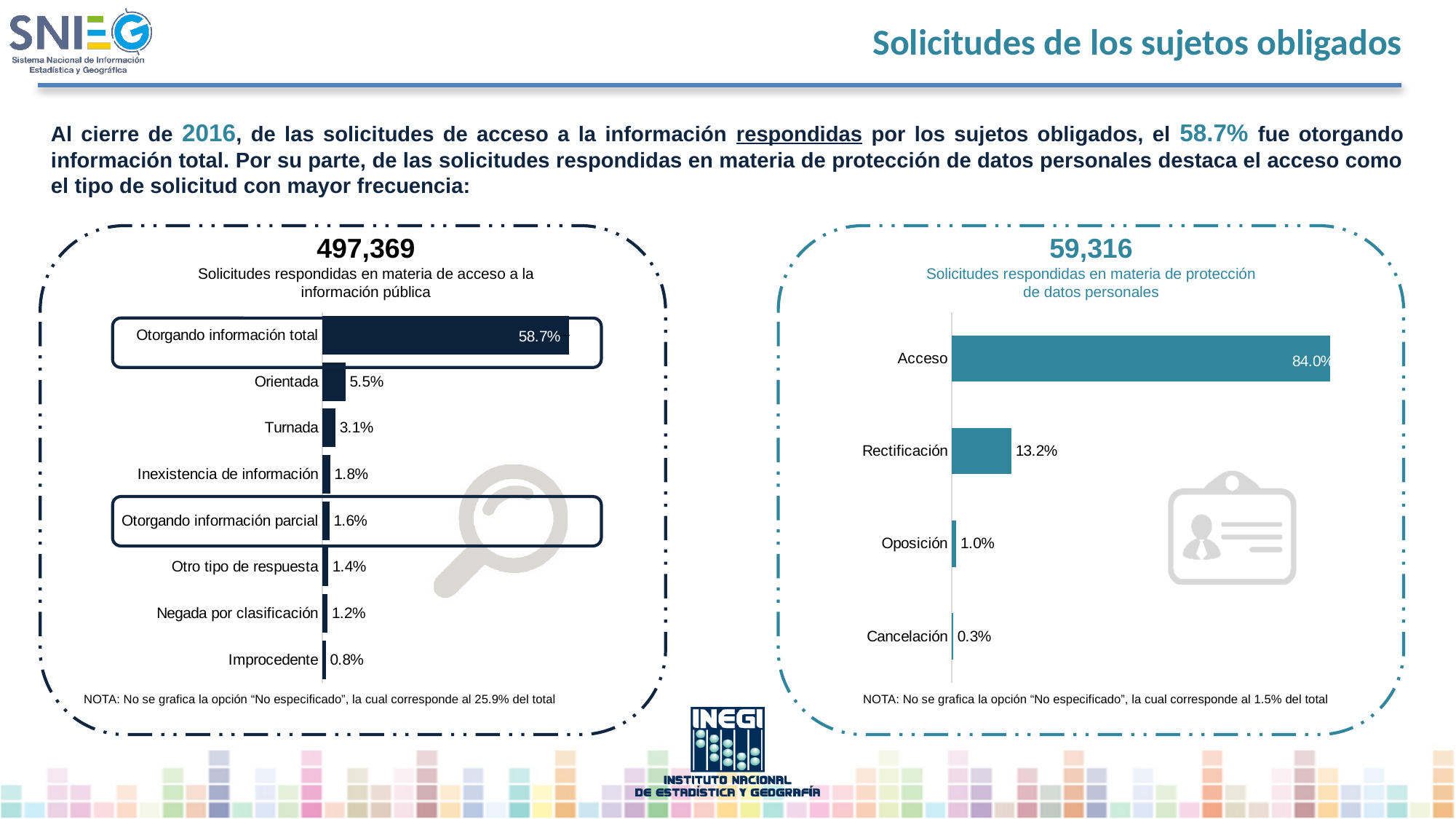
In the left chart (Solicitudes respondidas en materia de acceso a la información pública), what is the value for Otorgando información total? 58.7% In the right chart (Solicitudes respondidas en materia de protección de datos personales), which category has the highest value? Acceso In the left chart (Solicitudes respondidas en materia de acceso a la información pública), what is the value for Turnada? 3.1% In the left chart (Solicitudes respondidas en materia de acceso a la información pública), which category has the lowest value? Improcedente In the right chart (Solicitudes respondidas en materia de protección de datos personales), what is the value for Rectificación? 13.2% What total number of requests is shown above the left chart (Solicitudes respondidas en materia de acceso a la información pública)? 497,369 What kind of chart is the right chart (Solicitudes respondidas en materia de protección de datos personales)? Bar chart In the left chart (Solicitudes respondidas en materia de acceso a la información pública), which is larger, Inexistencia de información or Negada por clasificación? Inexistencia de información In the left chart (Solicitudes respondidas en materia de acceso a la información pública), how many categories are plotted? 8 In the right chart (Solicitudes respondidas en materia de protección de datos personales), how many categories are plotted? 4 In the left chart (Solicitudes respondidas en materia de acceso a la información pública), what is the difference between Orientada and Turnada? 2.4% In the right chart (Solicitudes respondidas en materia de protección de datos personales), what is the difference between Acceso and Rectificación? 70.8%